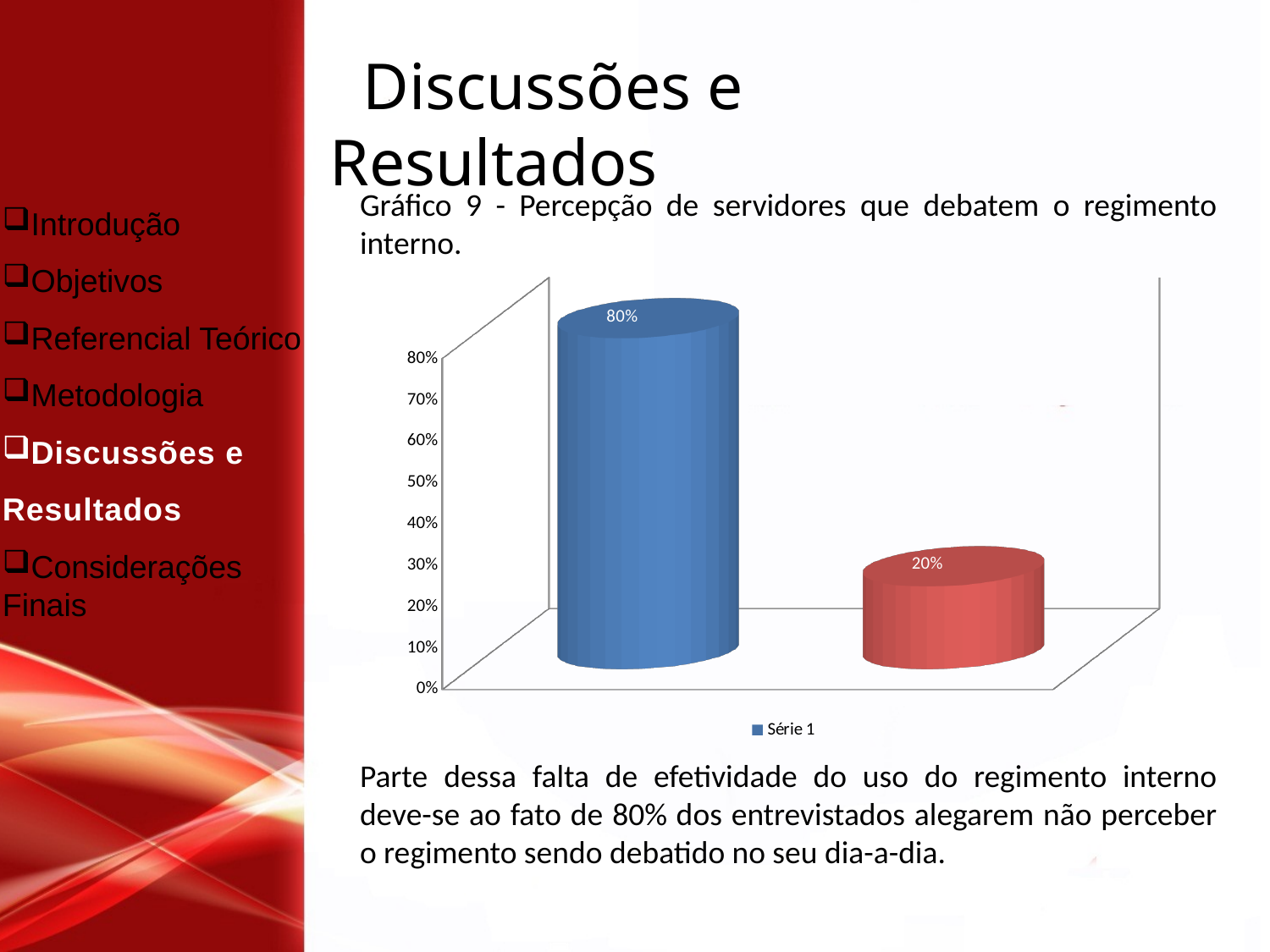
Is the value for the red bar greater or less than 30%? less Which bar has the lowest value, the blue one on the left or the red one on the right? the red bar on the right What is the name of the series shown in the chart legend? Série 1 Which bar has the highest value, the blue one on the left or the red one on the right? the blue bar on the left What value is shown on the red bar on the right of the chart? 20% How many series does the legend list? 1 What is the difference between the value of the blue bar and the value of the red bar? 60% Is the value for the blue bar greater or less than 50%? greater How many bars are plotted in the chart? 2 What kind of chart is shown on the slide? bar chart What value is shown on the blue bar on the left of the chart? 80% Is the value of the red bar larger or smaller than the value of the blue bar? smaller